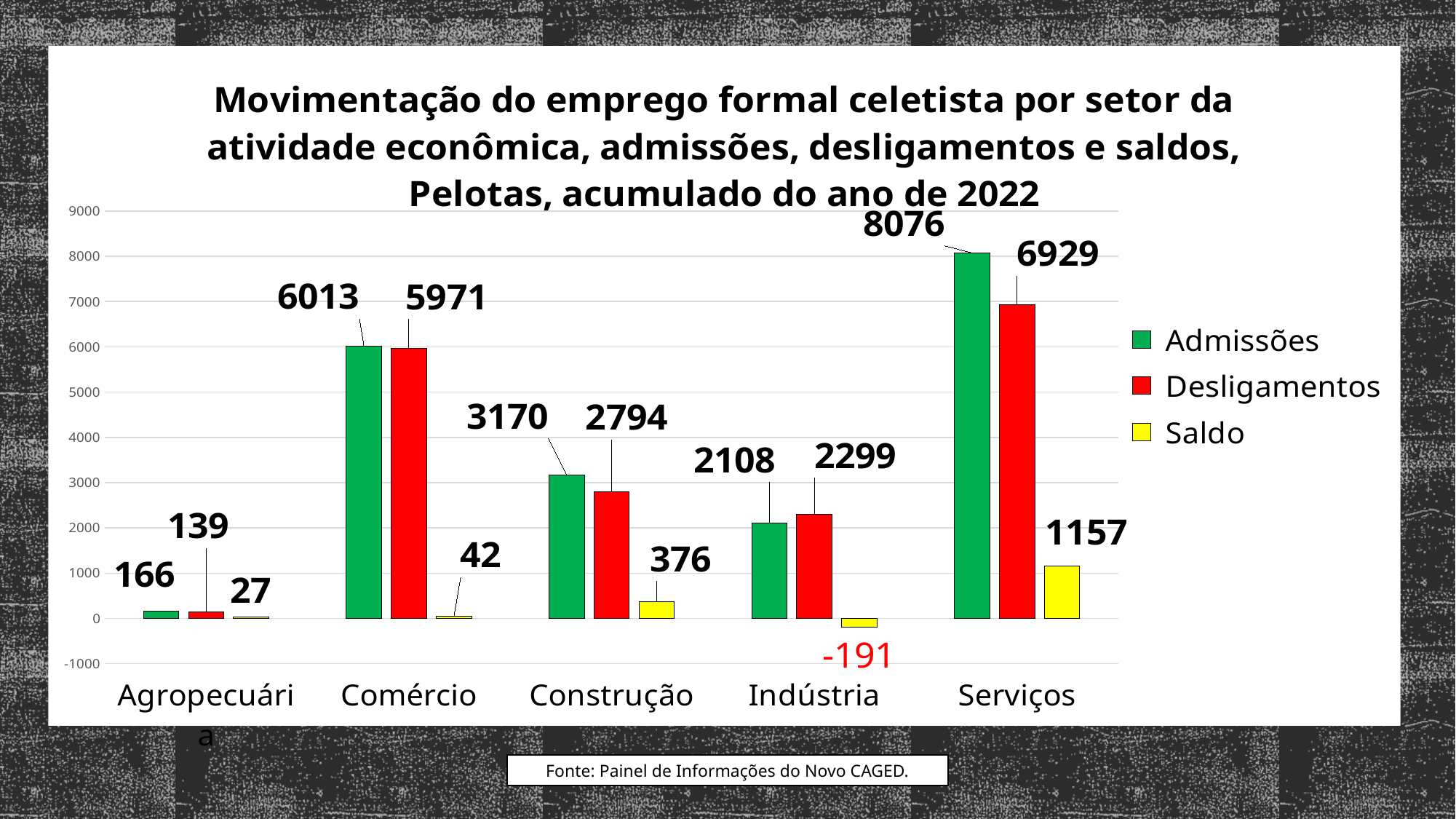
What is the difference between Admissões and Desligamentos for Construção? 376 What kind of chart is shown on the slide? bar chart Which is larger for Indústria, Admissões or Desligamentos? Desligamentos What is the Desligamentos value for Comércio? 5971 What is the Saldo value for Indústria? -191 Which sector has the highest Admissões value? Serviços Which sector has the lowest Desligamentos value? Agropecuária How many sectors are shown on the x axis? 5 Is the Desligamentos value for Serviços greater or less than 7000? less How many series does the legend list? 3 What colour represents the Saldo series in the legend? yellow What is the Admissões value for Serviços? 8076